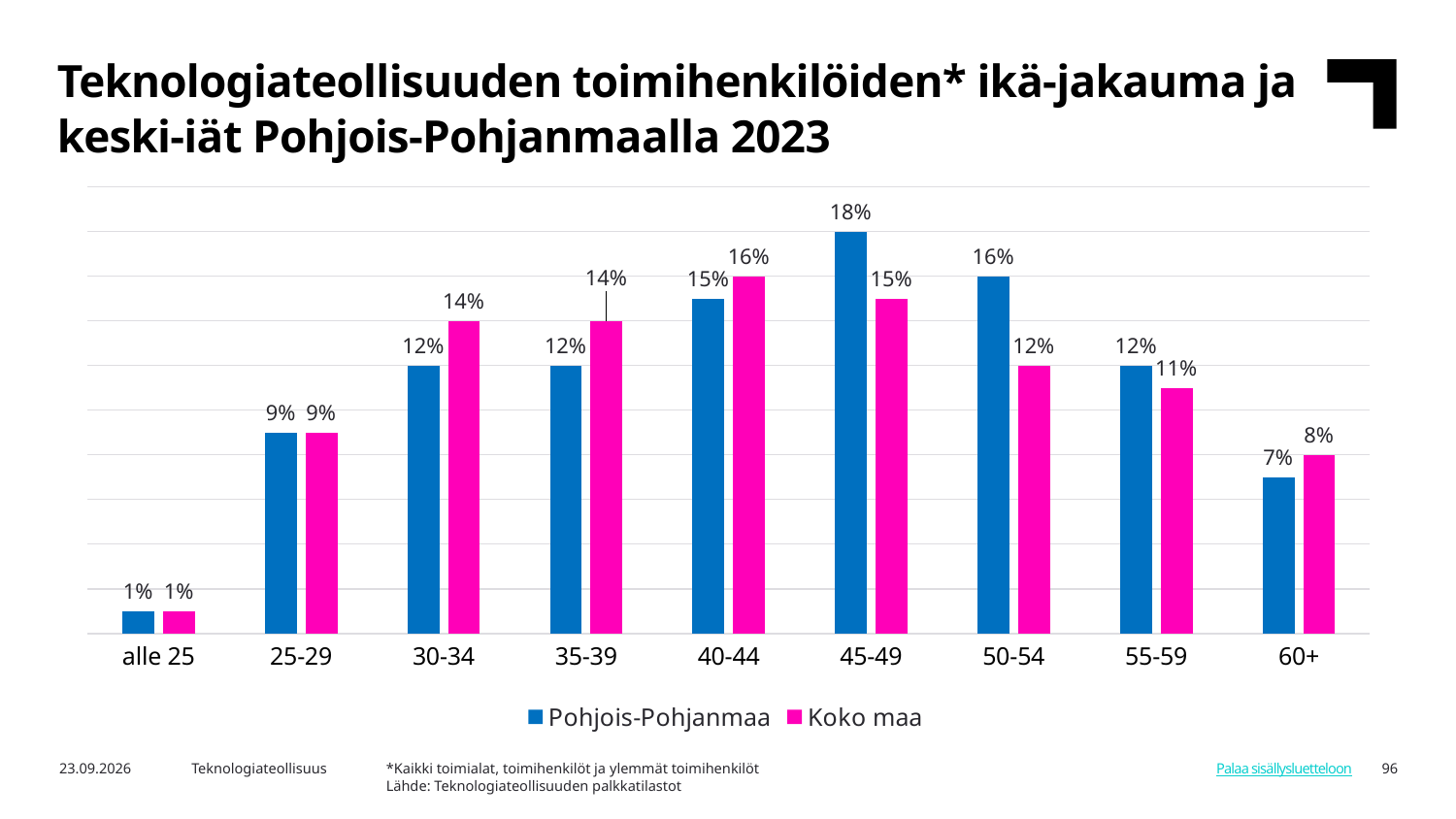
What is the difference between Pohjois-Pohjanmaa and Koko maa in the 45-49 age group? 3% Which age group has the highest value for Pohjois-Pohjanmaa? 45-49 Which colour represents Koko maa in the chart? Pink (magenta) What is the value for Koko maa in the 60+ age group? 8% What is the value for Pohjois-Pohjanmaa in the 45-49 age group? 18% Which series has the larger value in the 50-54 age group, Pohjois-Pohjanmaa or Koko maa? Pohjois-Pohjanmaa How many age groups are shown on the x axis? 9 What kind of chart is shown on the slide? Bar chart What is the value for Koko maa in the 35-39 age group? 14% Which series has the larger value in the 30-34 age group, Pohjois-Pohjanmaa or Koko maa? Koko maa Which age group has the lowest value for Koko maa? alle 25 How many series does the legend list? 2